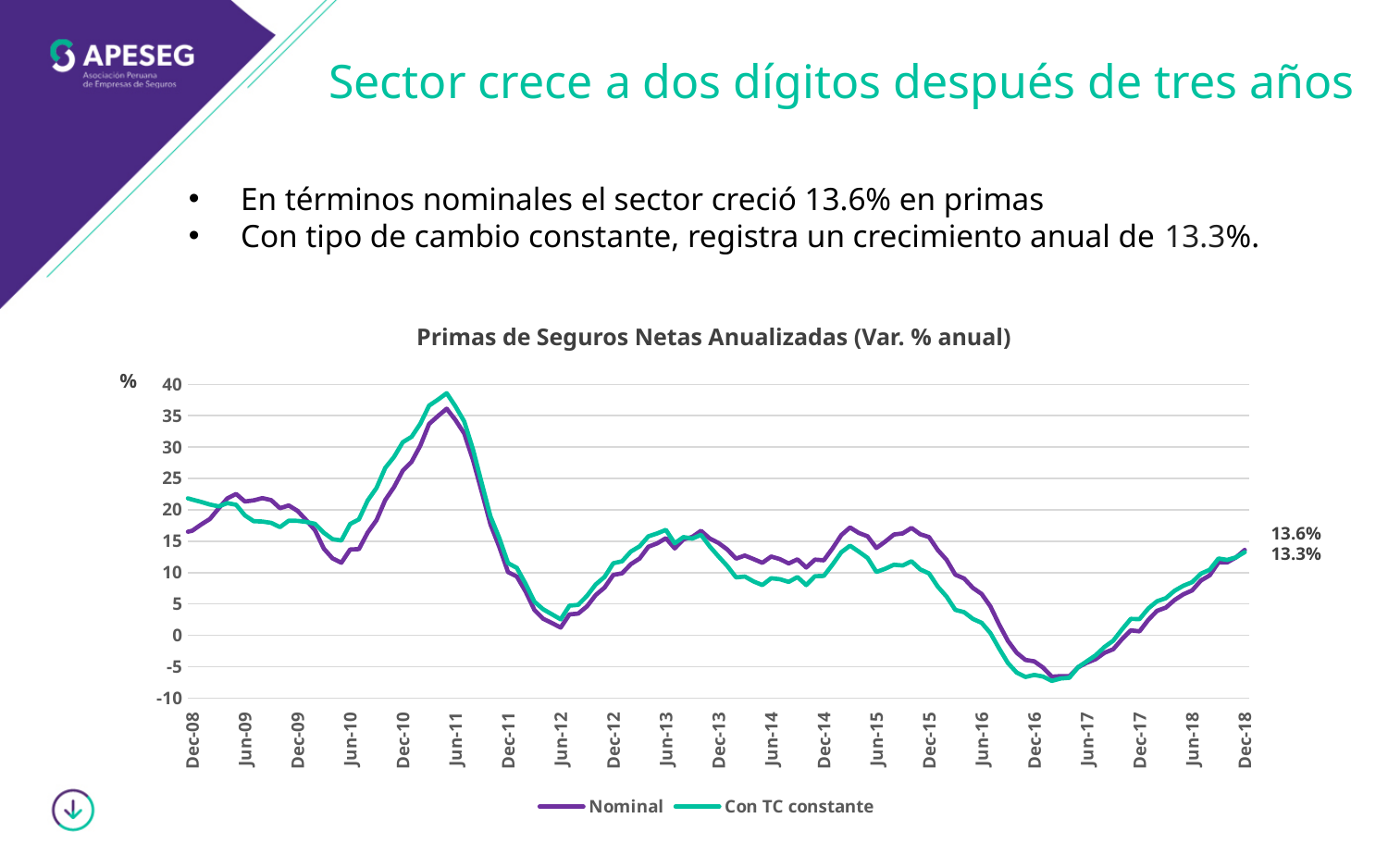
What kind of chart is shown on the slide? line chart What is the difference between the Nominal and Con TC constante values at Dec-18? 0.3% What is the value of the Con TC constante series at Dec-18? 13.3% What is the title of the chart? Primas de Seguros Netas Anualizadas (Var. % anual) Do the values rise or fall between Jun-17 and Dec-18? rise Is the value of the Nominal series at Dec-08 greater or less than 20? less Is the value of the Nominal series at Dec-16 greater or less than 0? less What is the value of the Nominal series at Dec-18? 13.6% Which series reaches the higher peak around Jun-11? Con TC constante At Dec-18, which series has the larger value, Nominal or Con TC constante? Nominal Is the value of the Nominal series at Jun-11 greater or less than 30? greater How many series does the chart's legend list? 2